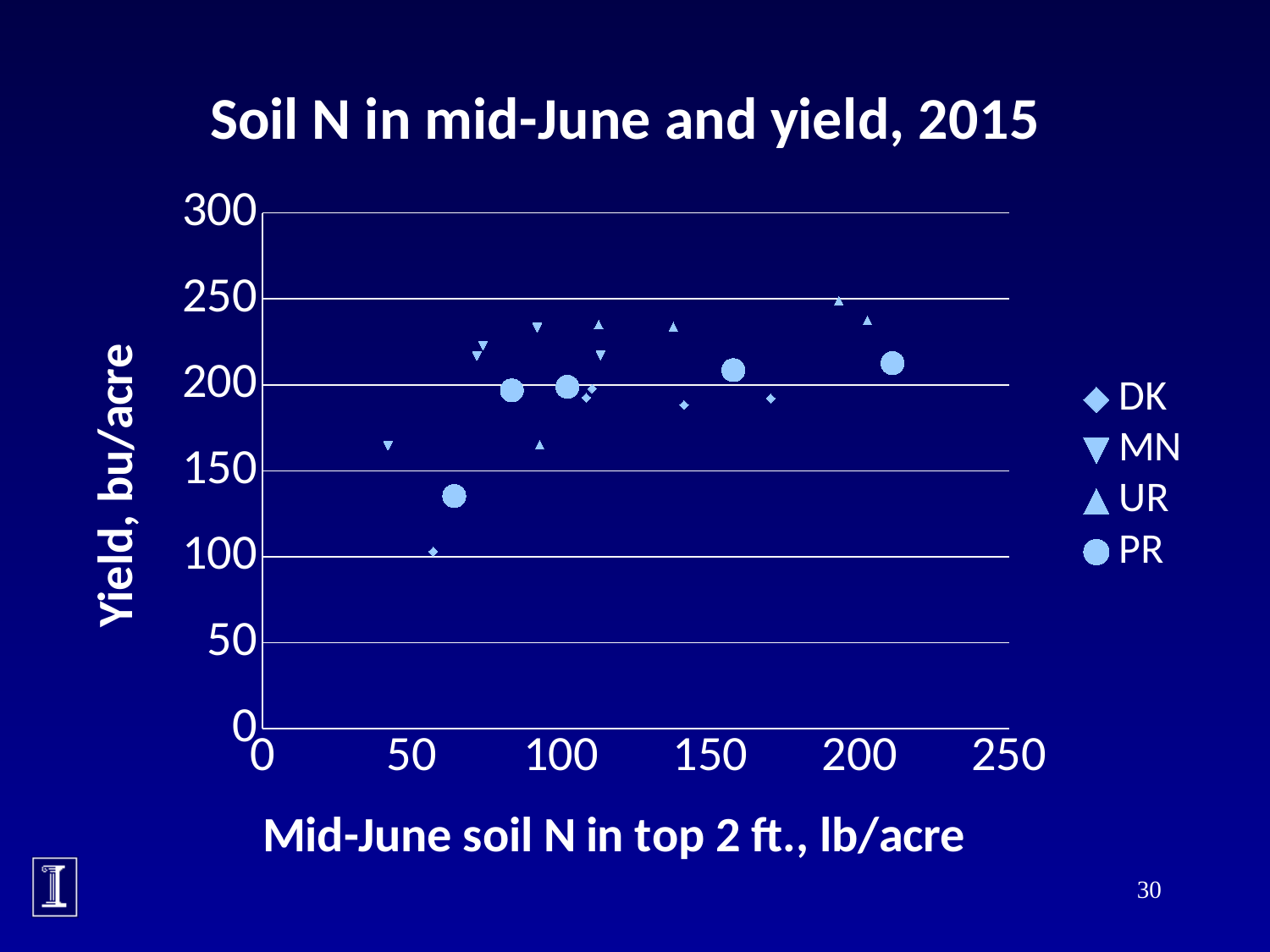
Is the yield of the rightmost PR point greater or less than 200 bu/acre? greater What is the title of the chart? Soil N in mid-June and yield, 2015 How many PR points (circles) are plotted on the chart? 5 What is the label of the y axis? Yield, bu/acre Which has the higher yield: the leftmost PR point or the rightmost PR point? The rightmost PR point How many series does the legend list? 4 Which series contains the point with the lowest yield? DK Which series contains the point with the highest yield? UR Is the yield of the lowest point on the chart greater or less than 150 bu/acre? less Do yields generally rise or fall as mid-June soil N increases along the x axis? Rise Is the yield of the leftmost PR point greater or less than 150 bu/acre? less What kind of chart is shown on the slide? Scatter chart